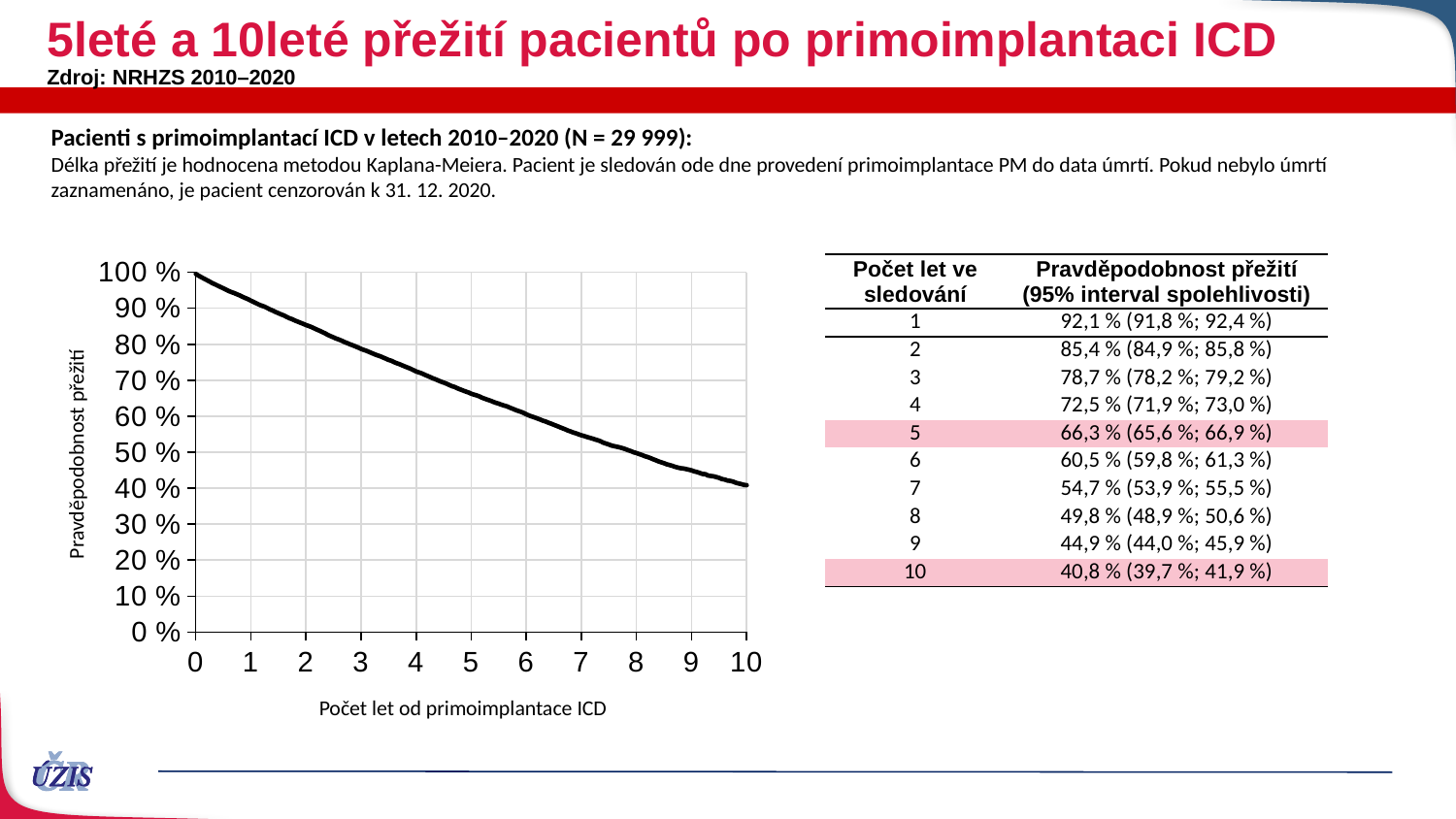
What is the 95% confidence interval for the 5-year survival probability shown in the table? (65,6 %; 66,9 %) According to the table, what is the survival probability after 5 years of follow-up? 66,3 % What kind of chart is shown on the slide? line chart Which year of follow-up in the table has the lowest survival probability? 10 Does the survival probability rise or fall as the number of years since ICD primoimplantation increases? fall How many years of follow-up are listed in the table? 10 What is the label of the x axis of the chart? Počet let od primoimplantace ICD Using the table values, what is the difference between the 5-year and 10-year survival probabilities? 25,5 % According to the table, what is the survival probability after 1 year of follow-up? 92,1 % According to the table, what is the survival probability after 10 years of follow-up? 40,8 % Is the survival probability at 5 years on the curve greater or less than 60 %? greater Is the survival probability at 10 years on the curve greater or less than 50 %? less